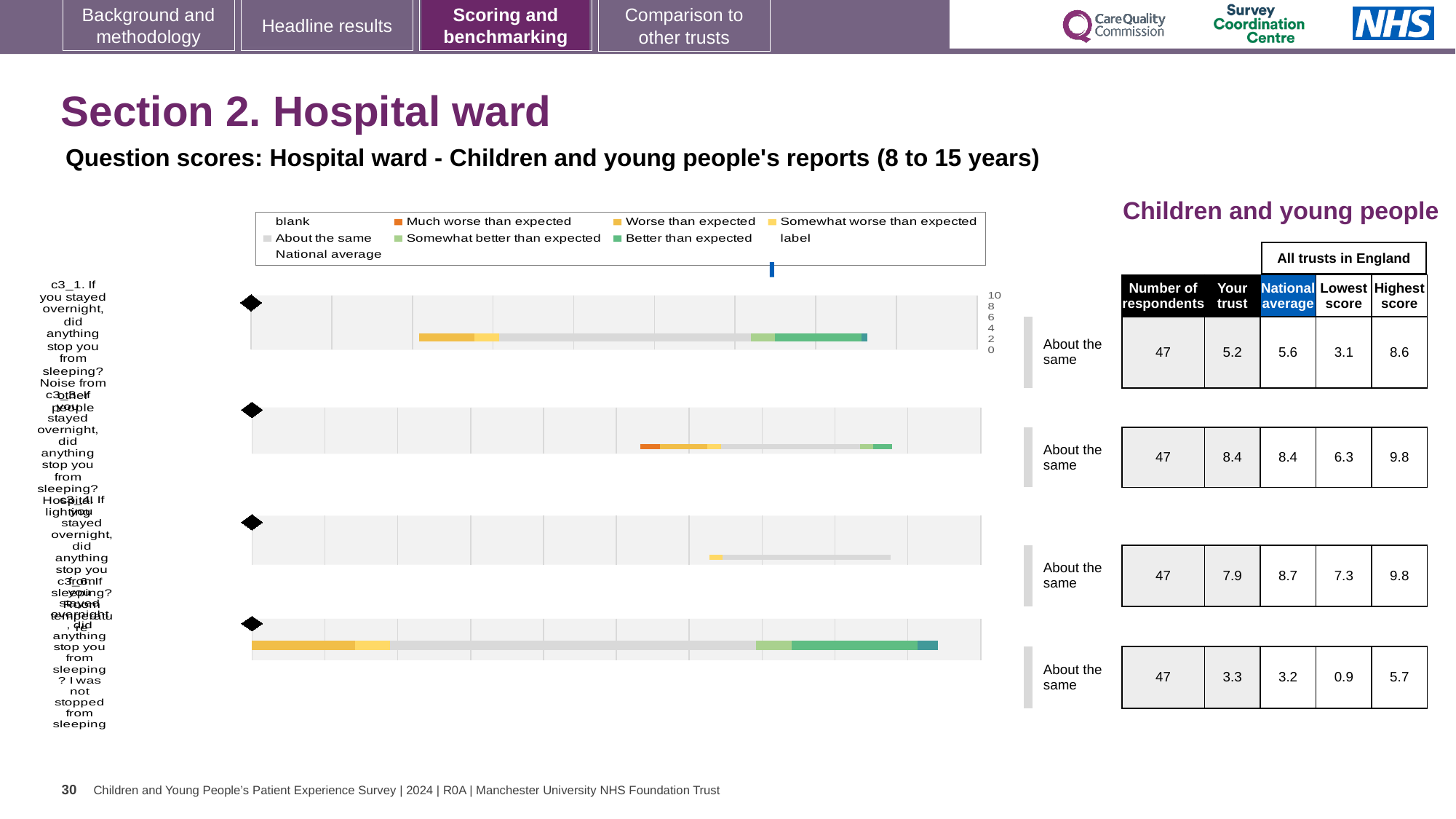
In the legend, what colour represents 'Better than expected'? green For the second chart (c3_3, hospital lighting), what is the 'Your trust' score? 8.4 What kind of chart is used to show the question scores on this slide? bar chart What benchmark category is shown next to each of the four charts? About the same For the bottom chart (c3_6, I was not stopped from sleeping), what is the lowest score among all trusts in England? 0.9 For the top chart (c3_1), what is the national average score shown in the table? 5.6 For the top chart (c3_1), which is larger: the 'Your trust' score or the national average? national average How many respondents are listed for each of the four questions? 47 For the top chart (c3_1, noise from other people), what is the 'Your trust' score shown in the table? 5.2 How many separate benchmark bar charts are shown on the slide? 4 Which of the four charts has the highest 'Your trust' score in the table? the second chart (c3_3), 8.4 For the third chart (c3_4), what is the difference between the national average and the 'Your trust' score? 0.8